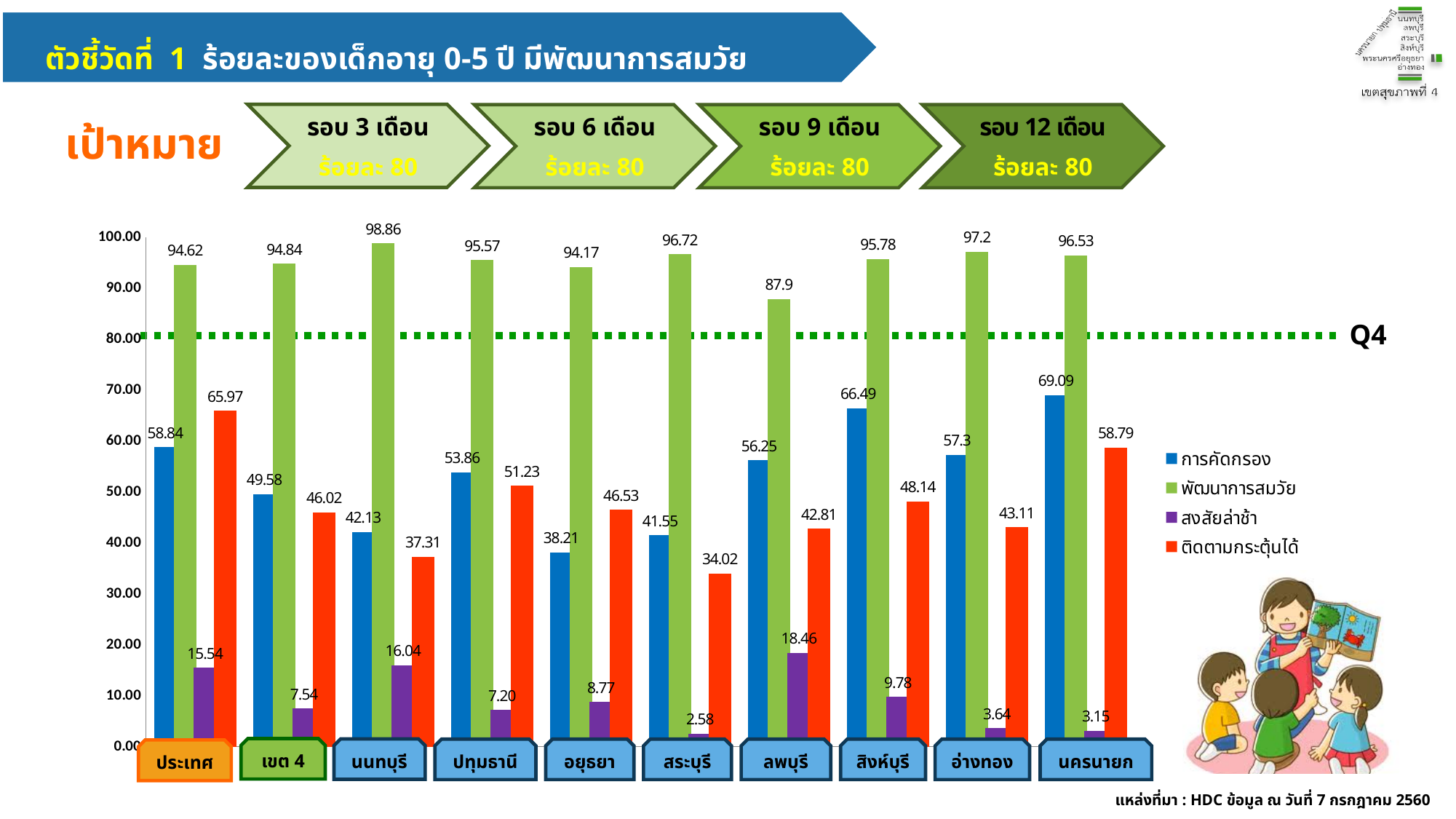
How many series does the legend list? 4 What is the difference between the การคัดกรอง values for นครนายก and สิงห์บุรี? 2.60 What is the value of ติดตามกระตุ้นได้ for สระบุรี? 34.02 What is the value of การคัดกรอง for ประเทศ? 58.84 What is the value of พัฒนาการสมวัย for นนทบุรี? 98.86 Which is larger: ติดตามกระตุ้นได้ for ปทุมธานี or for อยุธยา? ปทุมธานี What value does the dotted horizontal line labelled Q4 mark on the y axis? 80.00 Which category has the lowest value for สงสัยล่าช้า? สระบุรี What type of chart is shown on the slide? bar chart How many categories are shown on the x axis? 10 Which category has the lowest value for พัฒนาการสมวัย? ลพบุรี Which category has the highest value for พัฒนาการสมวัย? นนทบุรี